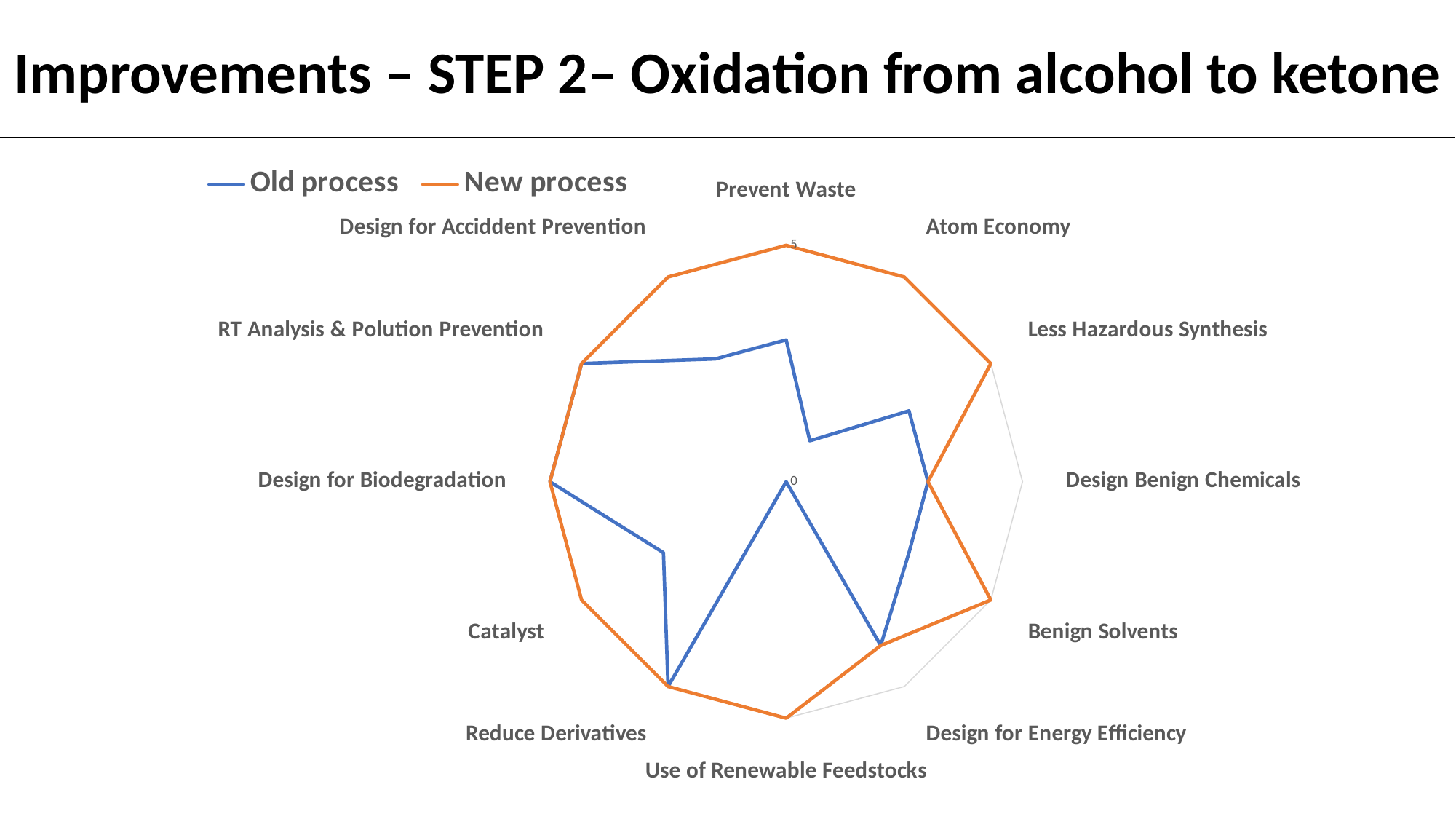
What is the New process value for Prevent Waste? 5 Which category has the lowest New process value? Design Benign Chemicals Which series is drawn in orange? New process What is the Old process value for Use of Renewable Feedstocks? 0 How many series does the legend list? 2 Which category has the lowest Old process value? Use of Renewable Feedstocks Is the Old process value for Atom Economy greater or less than 5? less For Catalyst, which series has the larger value, Old process or New process? New process What kind of chart is shown on the slide? Radar chart Which series is drawn in blue? Old process How many categories (axes) does the radar chart have? 12 For Atom Economy, which series has the larger value, Old process or New process? New process